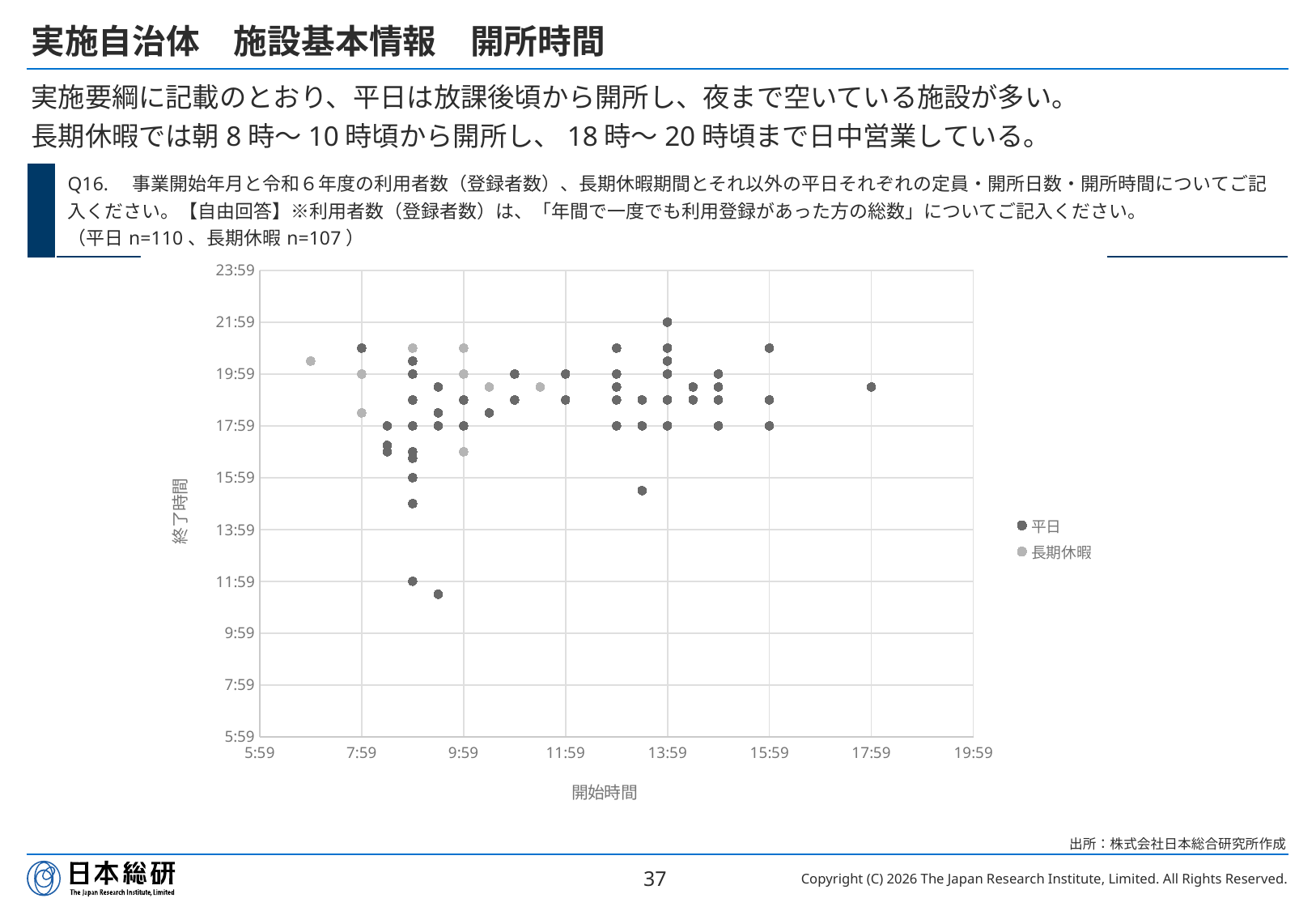
How many series does the chart legend list? 2 What is the highest tick label shown on the vertical axis of the chart? 23:59 Which series contains the point with the earliest start time (開始時間) on the chart? 長期休暇 What kind of chart is shown on the slide? scatter chart Is the start time of the leftmost point on the chart greater or less than 7:59? less Is the end time of the highest 平日 point on the chart greater or less than 19:59? greater Which series contains the point with the latest end time (終了時間) on the chart? 平日 What is the title of the horizontal axis of the chart? 開始時間 Is the start time of the rightmost point on the chart greater or less than 15:59? greater What are the two series named in the chart legend? 平日, 長期休暇 According to the slide, what is the sample size (n) for the 平日 series? 110